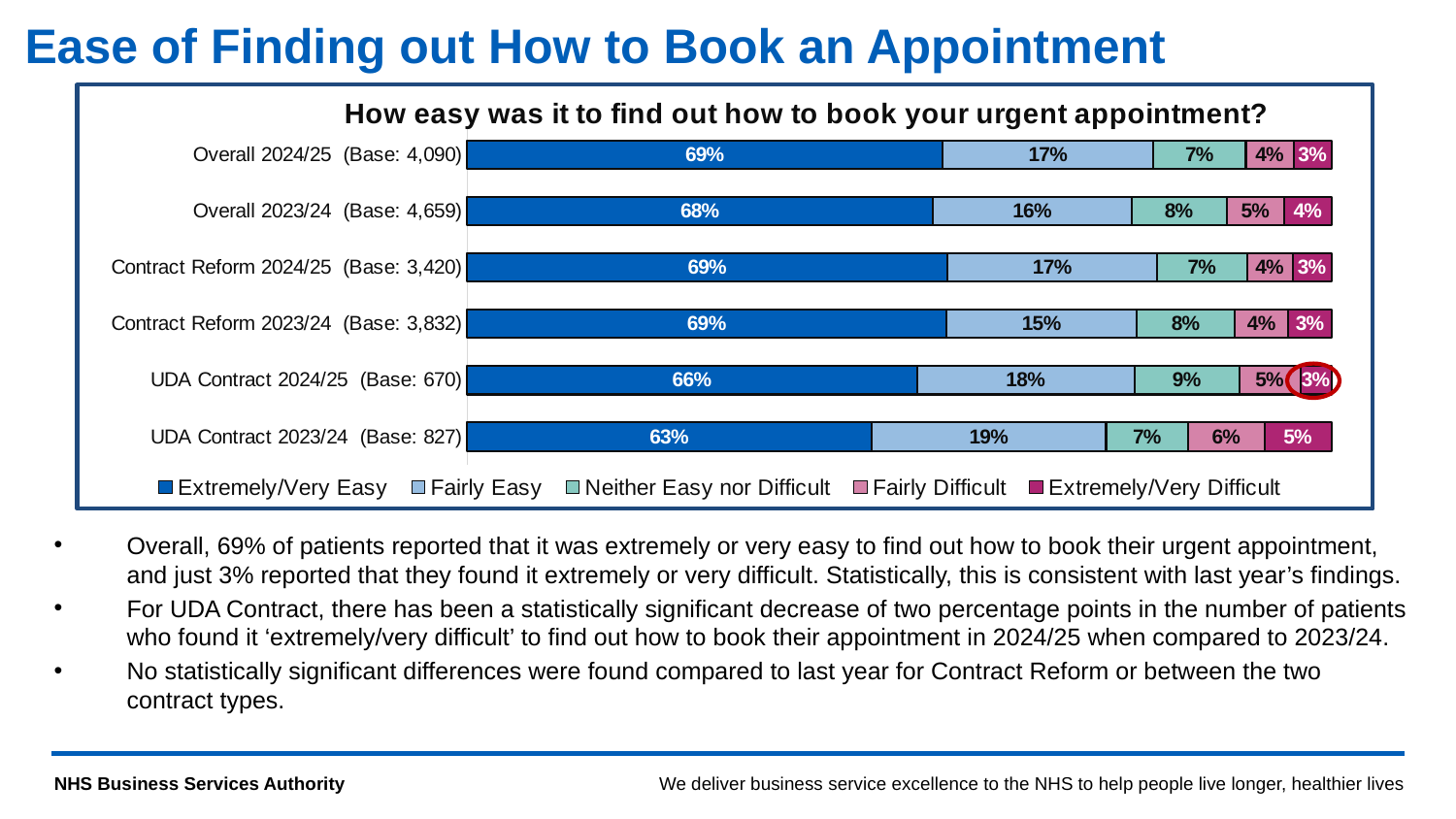
What is the Extremely/Very Difficult value for UDA Contract 2024/25? 3% What percentage of UDA Contract 2023/24 respondents said it was Extremely/Very Easy to find out how to book their urgent appointment? 63% Which category has the highest Fairly Easy percentage? UDA Contract 2023/24 What is the Fairly Easy value for Overall 2024/25? 17% Which has the larger Neither Easy nor Difficult value: UDA Contract 2024/25 or Overall 2024/25? UDA Contract 2024/25 What type of chart is shown on the slide? Stacked bar chart What is the Fairly Difficult value for UDA Contract 2023/24? 6% How many series does the legend list? 5 How many categories (bars) are shown in the chart? 6 Which category has the highest Extremely/Very Difficult percentage? UDA Contract 2023/24 Which category has the lowest Extremely/Very Easy percentage? UDA Contract 2023/24 By how many percentage points does the Extremely/Very Easy value for UDA Contract 2024/25 exceed that for UDA Contract 2023/24? 3 percentage points